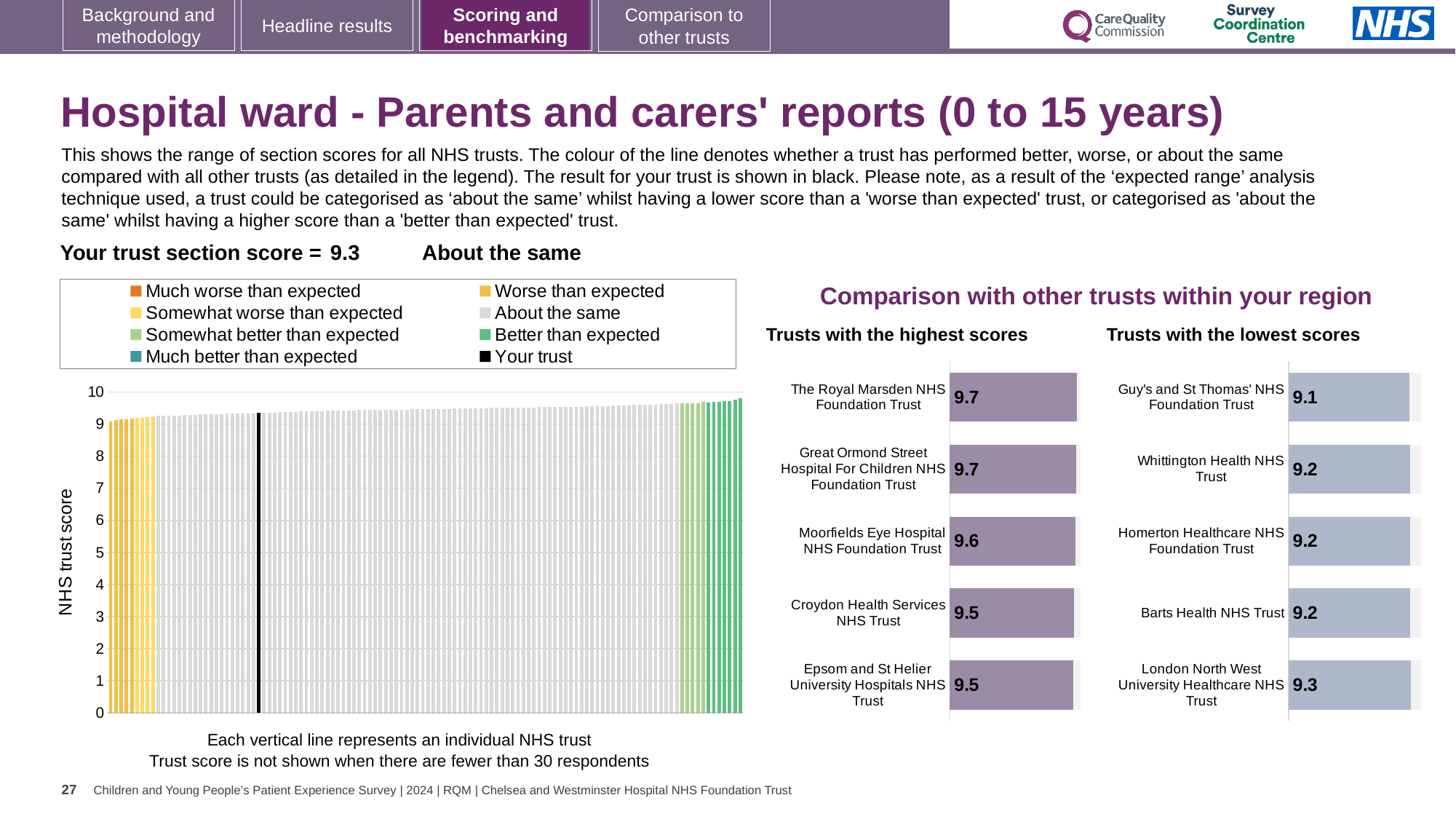
How many entries does the legend of the main NHS trust score chart list? 8 What kind of chart is the 'Trusts with the highest scores' chart? Bar chart In the main NHS trust score chart on the left, do the values rise or fall from left to right along the x axis? rise In the 'Trusts with the lowest scores' chart, what is the score for Whittington Health NHS Trust? 9.2 In the 'Trusts with the highest scores' chart, what is the score for Croydon Health Services NHS Trust? 9.5 In the 'Trusts with the lowest scores' chart, which trust has the highest score? London North West University Healthcare NHS Trust In the 'Trusts with the lowest scores' chart, which trust has the lowest score? Guy's and St Thomas' NHS Foundation Trust In the 'Trusts with the highest scores' chart, which has the larger score: Moorfields Eye Hospital NHS Foundation Trust or Croydon Health Services NHS Trust? Moorfields Eye Hospital NHS Foundation Trust In the 'Trusts with the highest scores' chart, what is the difference between the scores of The Royal Marsden NHS Foundation Trust and Epsom and St Helier University Hospitals NHS Trust? 0.2 How many trusts are shown in the 'Trusts with the lowest scores' chart? 5 In the 'Trusts with the highest scores' chart, what is the score for Moorfields Eye Hospital NHS Foundation Trust? 9.6 In the main NHS trust score chart on the left, is the value for the black 'Your trust' line greater or less than 5? greater